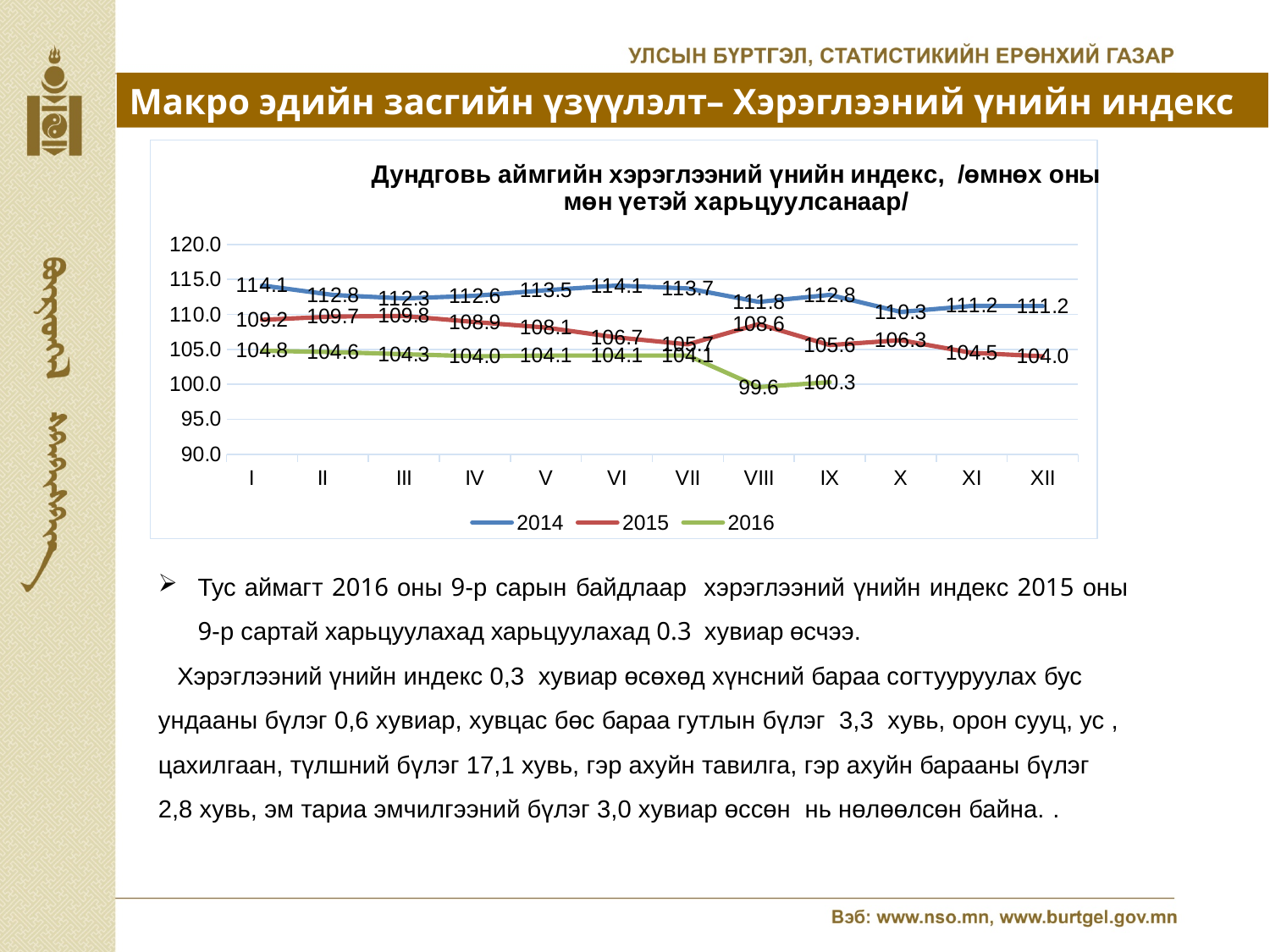
In which month does the 2016 series reach its lowest value? VIII What is the value of the 2015 series in month XII? 104.0 In which month does the 2014 series reach its lowest value? X What is the difference between the 2014 and 2015 values in month IX? 7.2 Is the value for the 2016 series in month IX greater or less than 105.0? less What is the value of the 2016 series in month VIII? 99.6 Does the 2016 series rise or fall overall from month I to month IX? fall What is the value of the 2014 series in month I? 114.1 What kind of chart is shown on the slide? line chart How many months are shown along the x axis? 12 How many series does the legend list? 3 Which series has the larger value in month VIII, 2015 or 2016? 2015